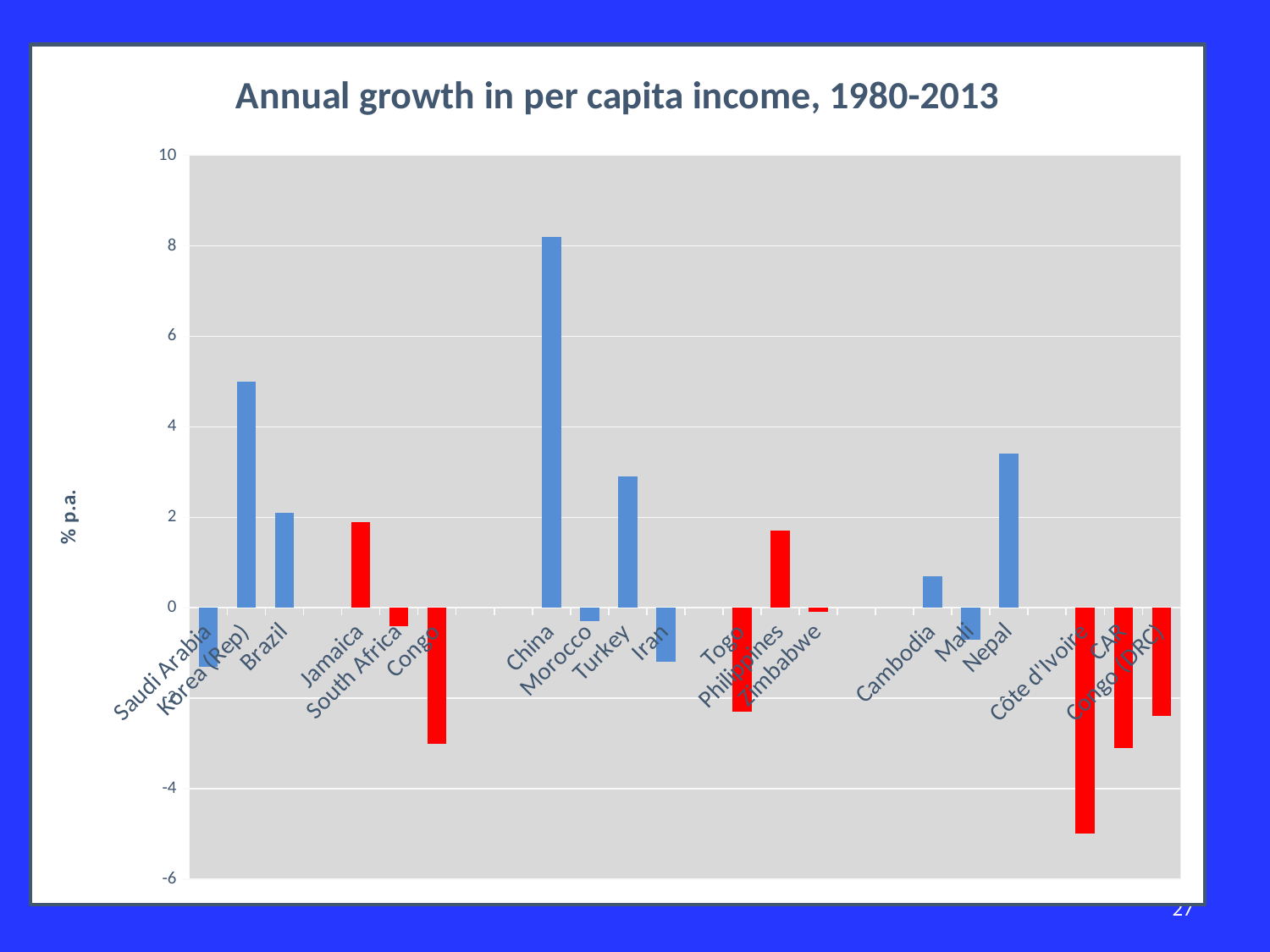
Is the value for China greater or less than 6? greater What is the title of the chart? Annual growth in per capita income, 1980-2013 Which has the larger value, Korea (Rep) or Brazil? Korea (Rep) Is the value for Côte d'Ivoire greater or less than -4? less What kind of chart is shown on the slide? bar chart Is the value for Congo greater or less than -2? less What is the label on the vertical axis? % p.a. Which country has the highest annual growth in per capita income? China Which has the larger value, Nepal or Turkey? Nepal Which country has the lowest annual growth in per capita income? Côte d'Ivoire How many countries are shown on the chart? 19